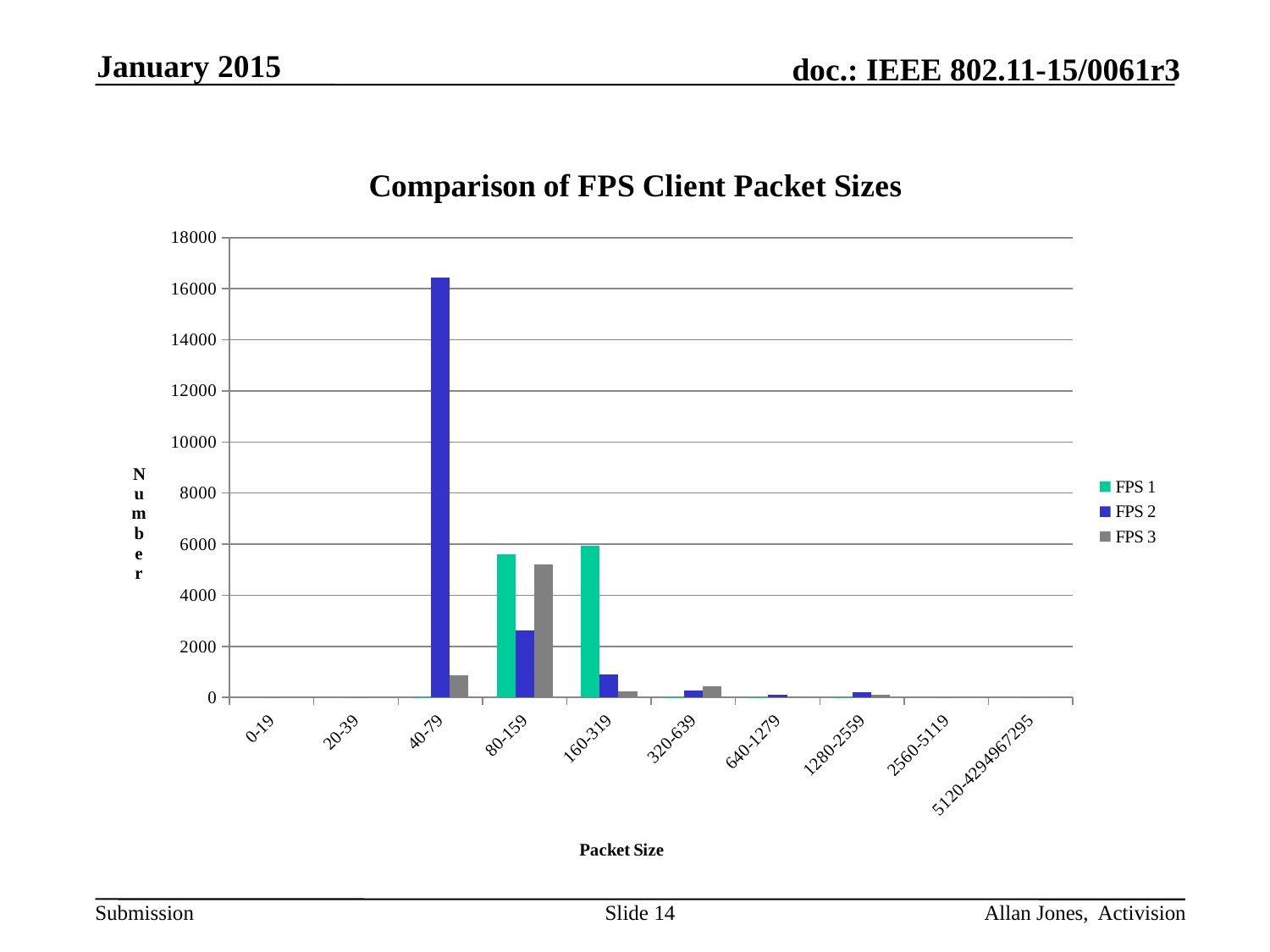
What kind of chart is shown on the slide? bar chart What is the label of the x axis? Packet Size Is the value for FPS 3 in the 80-159 category greater or less than 4000? greater In the 80-159 category, which series has the larger value, FPS 1 or FPS 2? FPS 1 In the 40-79 category, which series has the larger value, FPS 2 or FPS 3? FPS 2 How many packet size categories are shown on the x axis? 10 Is the value for FPS 2 in the 80-159 category greater or less than 2000? greater Is the value for FPS 1 in the 80-159 category greater or less than 6000? less For which packet size category does FPS 2 have its highest value? 40-79 What is the title of the chart? Comparison of FPS Client Packet Sizes How many series does the legend list? 3